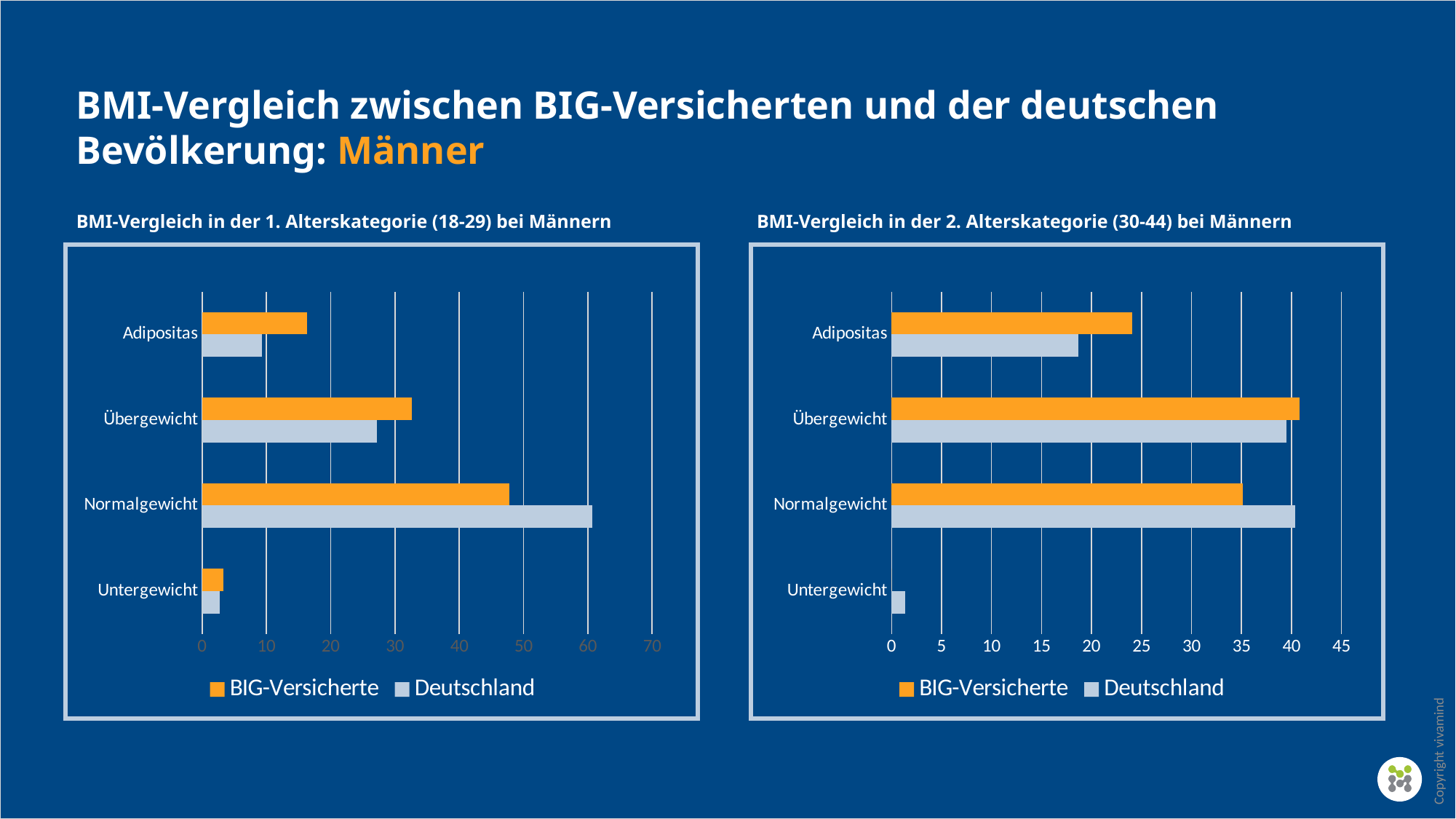
How many categories are shown in the 'BMI-Vergleich in der 2. Alterskategorie (30-44) bei Männern' chart? 4 In the left chart (18-29), which category has the highest value for Deutschland? Normalgewicht In the right chart (30-44), which category has the highest value for Deutschland? Normalgewicht How many series does the legend of the left chart list? 2 Which colour represents BIG-Versicherte in the legends of both charts? orange In the left chart (18-29), which category has the lowest value for BIG-Versicherte? Untergewicht What kind of chart is the 'BMI-Vergleich in der 1. Alterskategorie (18-29) bei Männern' chart? bar chart In the left chart (18-29), is the Adipositas value for BIG-Versicherte greater or less than 20? less In the left chart (18-29), which is larger for Normalgewicht: BIG-Versicherte or Deutschland? Deutschland In the right chart (30-44), which is larger for Adipositas: BIG-Versicherte or Deutschland? BIG-Versicherte